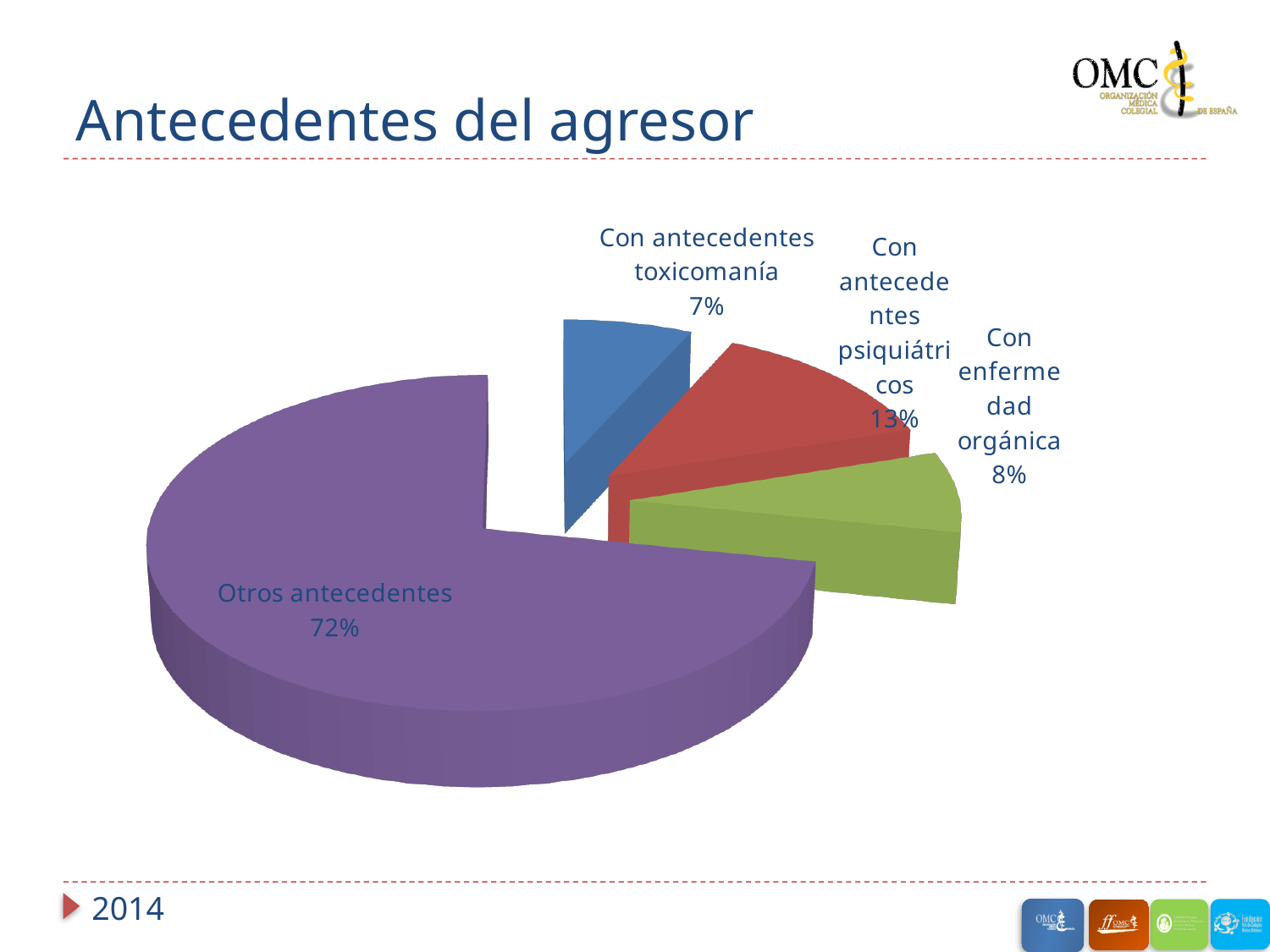
What is the title of the chart on the slide? Antecedentes del agresor What kind of chart is shown on the slide? Pie chart What percentage is shown for "Otros antecedentes"? 72% What percentage is shown for "Con antecedentes psiquiátricos"? 13% What percentage is shown for "Con enfermedad orgánica"? 8% What is the difference in percentage points between "Otros antecedentes" and "Con antecedentes psiquiátricos"? 59 How many slices does the pie chart have? 4 What colour is the slice for "Otros antecedentes"? Purple Which category has the smallest share of the pie? Con antecedentes toxicomanía What percentage is shown for "Con antecedentes toxicomanía"? 7% Which category has the largest share of the pie? Otros antecedentes Which is larger, the share for "Con antecedentes psiquiátricos" or for "Con enfermedad orgánica"? Con antecedentes psiquiátricos